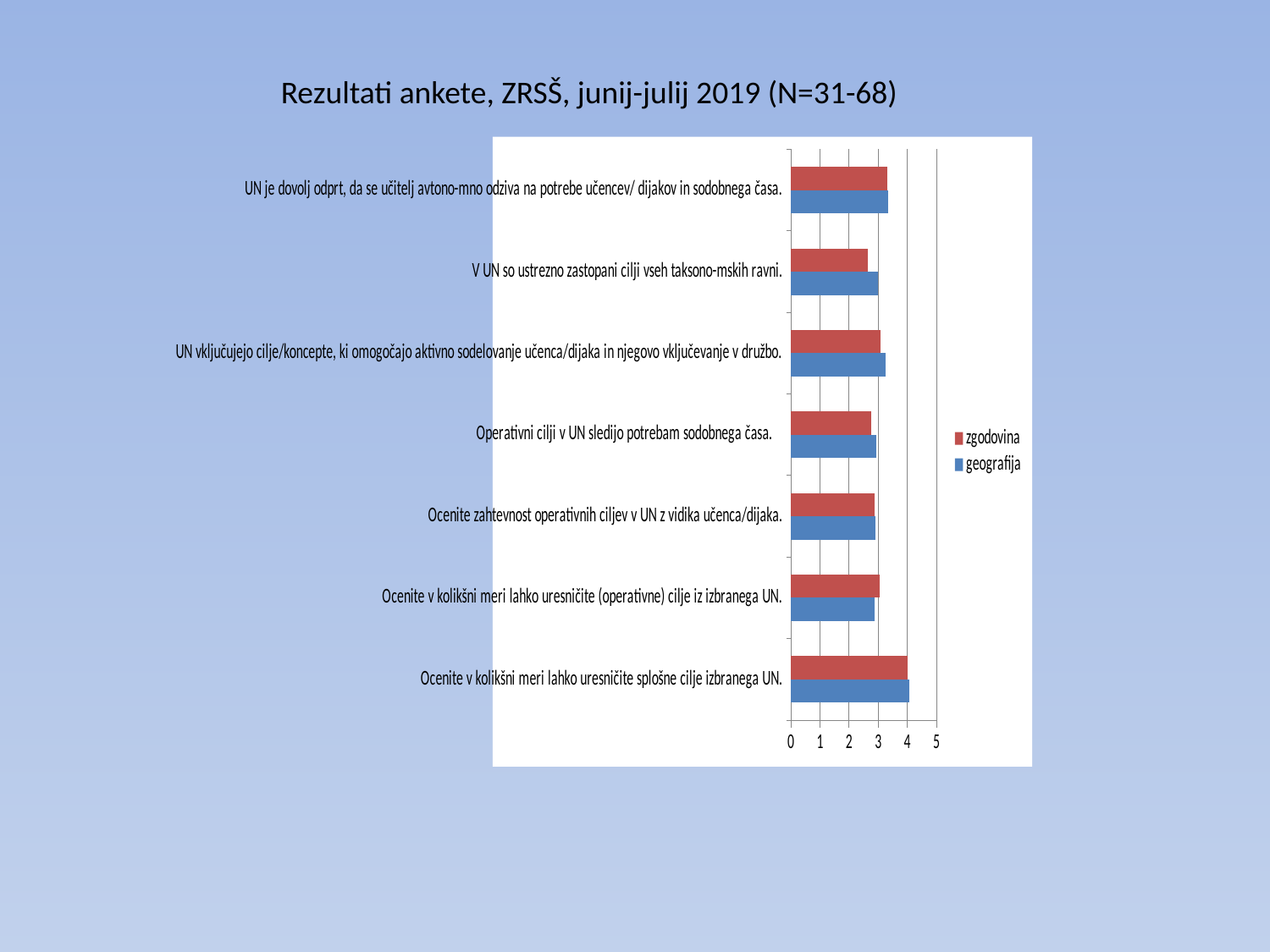
Is the zgodovina value for "UN je dovolj odprt, da se učitelj avtono-mno odziva na potrebe učencev/ dijakov in sodobnega časa." greater or less than 3? greater For which category is the geografija value highest? Ocenite v kolikšni meri lahko uresničite splošne cilje izbranega UN. What kind of chart is shown on the slide? bar chart Is the geografija value for "Ocenite v kolikšni meri lahko uresničite splošne cilje izbranega UN." greater or less than 3? greater Is the zgodovina value for "V UN so ustrezno zastopani cilji vseh taksono-mskih ravni." greater or less than 3? less How many series does the legend list? 2 Which series is shown in red in the legend? zgodovina How many categories (survey statements) are plotted on the chart? 7 For which category is the zgodovina value highest? Ocenite v kolikšni meri lahko uresničite splošne cilje izbranega UN. What is the title of the slide containing the chart? Rezultati ankete, ZRSŠ, junij-julij 2019 (N=31-68) What is the maximum value shown on the horizontal axis? 5 For "V UN so ustrezno zastopani cilji vseh taksono-mskih ravni.", which series has the larger value, zgodovina or geografija? geografija